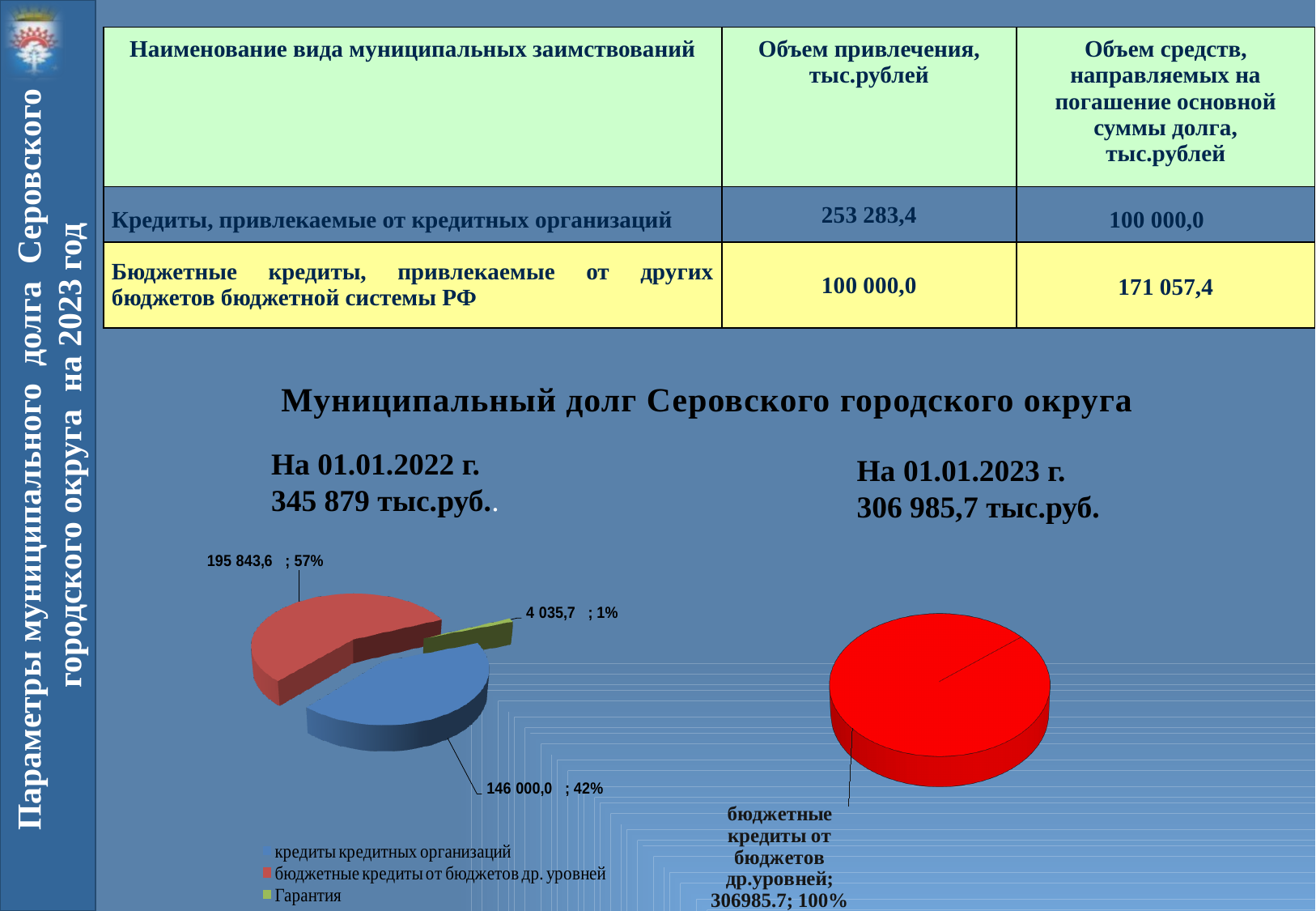
In the pie chart for 01.01.2023, what is the value shown for бюджетные кредиты от бюджетов др.уровней? 306985.7 In the pie chart for 01.01.2022, what share of the pie does бюджетные кредиты от бюджетов др. уровней take? 57% In the pie chart for 01.01.2023, what share of the pie does бюджетные кредиты от бюджетов др.уровней take? 100% What kind of chart is used to show the municipal debt as of 01.01.2022? pie chart In the pie chart for 01.01.2022, what is the value for Гарантия? 4 035,7 How many entries does the legend of the 01.01.2022 pie chart list? 3 In the pie chart for 01.01.2022, how many slices are there? 3 In the pie chart for 01.01.2022, what is the value for бюджетные кредиты от бюджетов др. уровней? 195 843,6 In the pie chart for 01.01.2022, what share of the pie does кредиты кредитных организаций take? 42% In the pie chart for 01.01.2022, which category has the largest slice? бюджетные кредиты от бюджетов др. уровней In the pie chart for 01.01.2022, what is the value for кредиты кредитных организаций? 146 000,0 In the pie chart for 01.01.2022, which category has the smallest slice? Гарантия